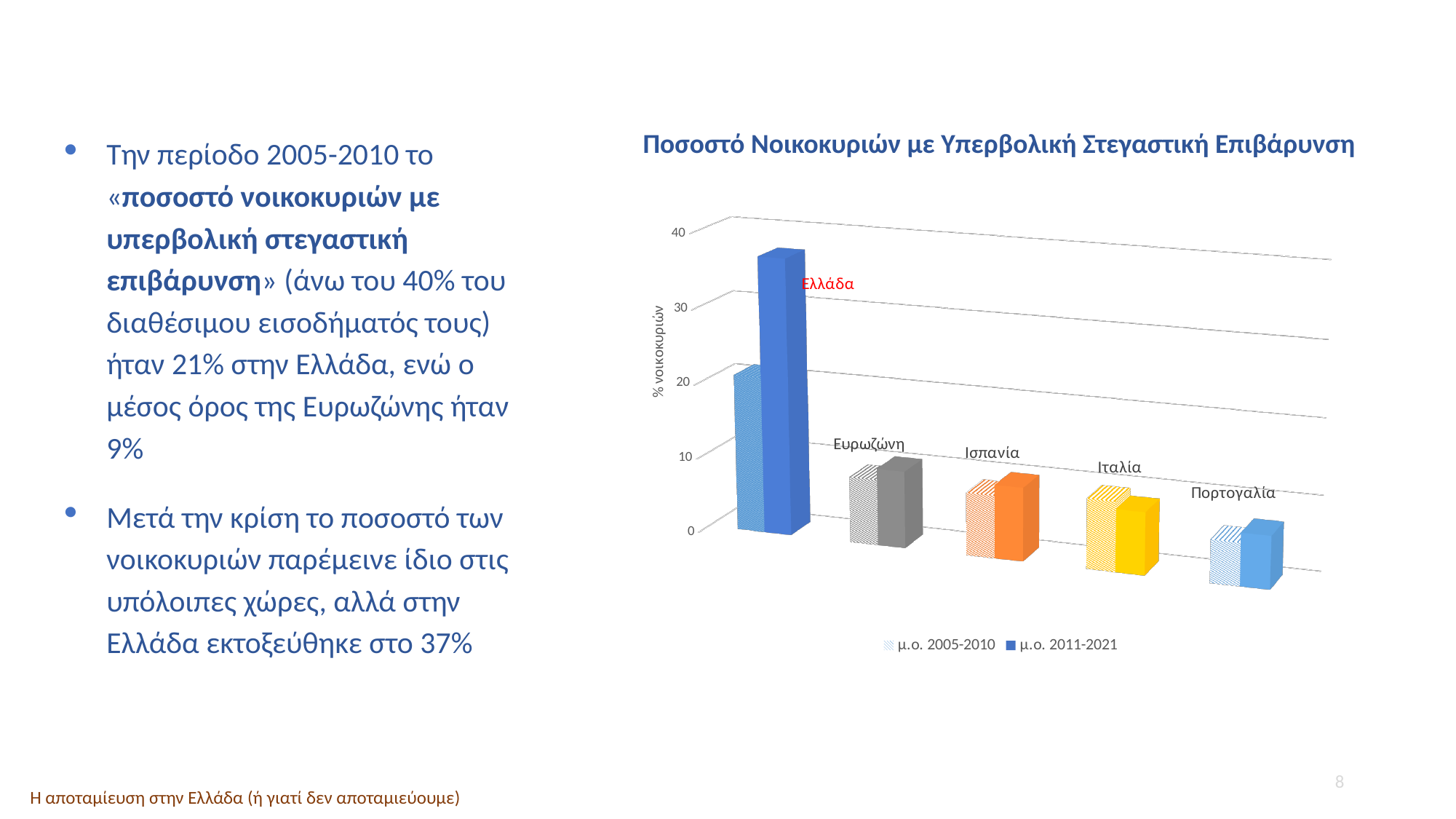
How many series does the chart legend list? 2 Is the μ.ο. 2011-2021 value for Πορτογαλία greater or less than 10? less Which category has the lowest bar for the μ.ο. 2011-2021 series? Πορτογαλία What is the title of the chart? Ποσοστό Νοικοκυριών με Υπερβολική Στεγαστική Επιβάρυνση What kind of chart is shown on the slide? bar chart What is the label of the vertical axis of the chart? % νοικοκυριών Is the μ.ο. 2011-2021 value for Ευρωζώνη greater or less than 20? less Is the μ.ο. 2005-2010 value for Ελλάδα greater or less than 10? greater For Ελλάδα, which series has the larger value: μ.ο. 2005-2010 or μ.ο. 2011-2021? μ.ο. 2011-2021 How many countries/regions are shown on the chart? 5 Which category has the highest bar for the μ.ο. 2011-2021 series? Ελλάδα